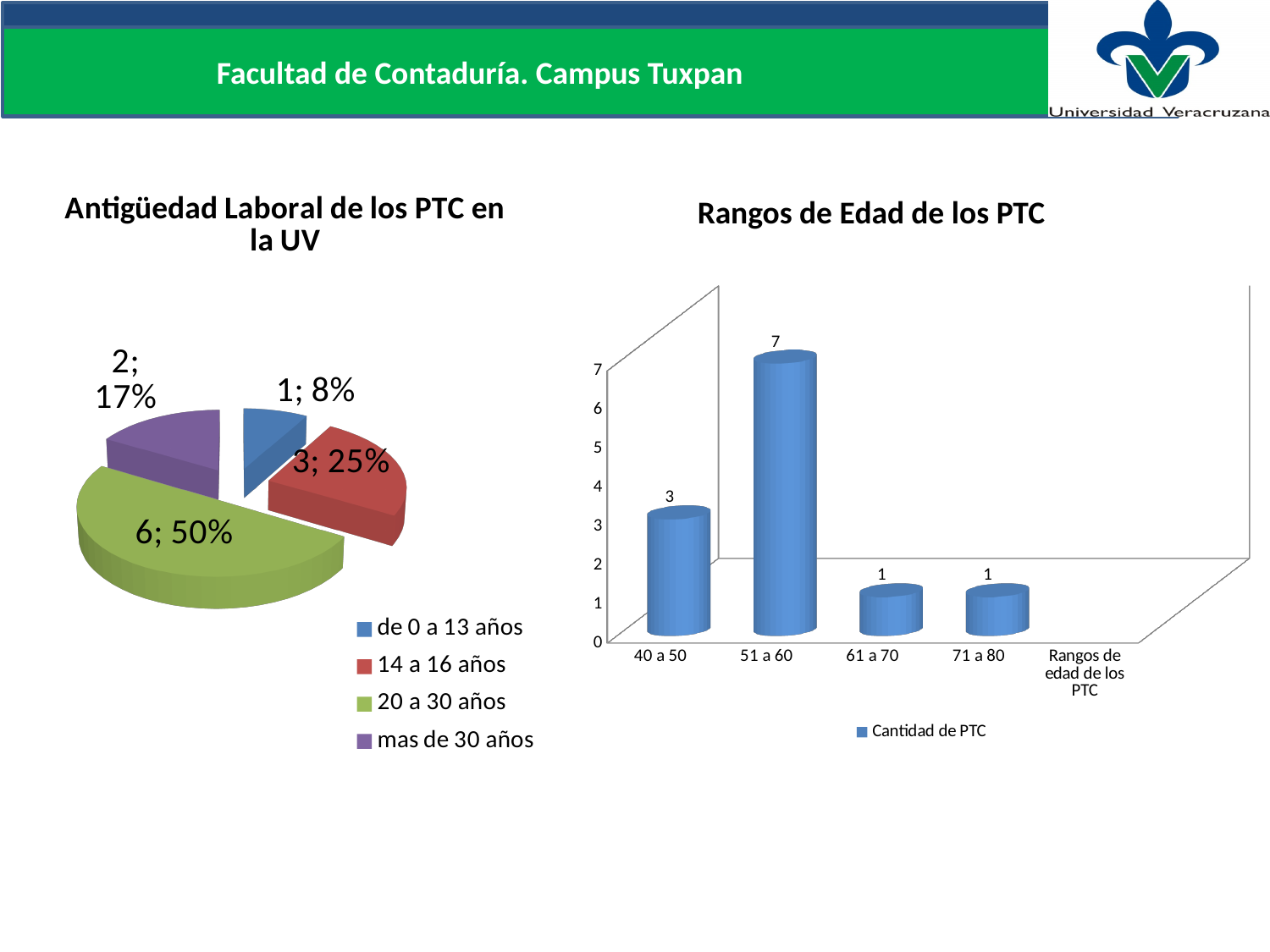
What kind of chart is 'Antigüedad Laboral de los PTC en la UV'? Pie chart In the 'Antigüedad Laboral de los PTC en la UV' chart, what is the value for '14 a 16 años'? 3 In the 'Rangos de Edad de los PTC' chart, what is the value for the 51 a 60 category? 7 In the 'Antigüedad Laboral de los PTC en la UV' chart, which category has the smallest slice? de 0 a 13 años In the 'Rangos de Edad de los PTC' chart, what is the value for the 40 a 50 category? 3 In the 'Rangos de Edad de los PTC' chart, which category has the highest value? 51 a 60 How many categories does the legend of the 'Antigüedad Laboral de los PTC en la UV' chart list? 4 In the 'Rangos de Edad de los PTC' chart, what is the difference between the values for 51 a 60 and 40 a 50? 4 In the 'Rangos de Edad de los PTC' chart, which is larger, the value for 40 a 50 or the value for 61 a 70? 40 a 50 In the 'Rangos de Edad de los PTC' chart, what series does the legend list? Cantidad de PTC In the 'Antigüedad Laboral de los PTC en la UV' chart, what share of the pie does the '20 a 30 años' slice represent? 50% What kind of chart is 'Rangos de Edad de los PTC'? Bar chart